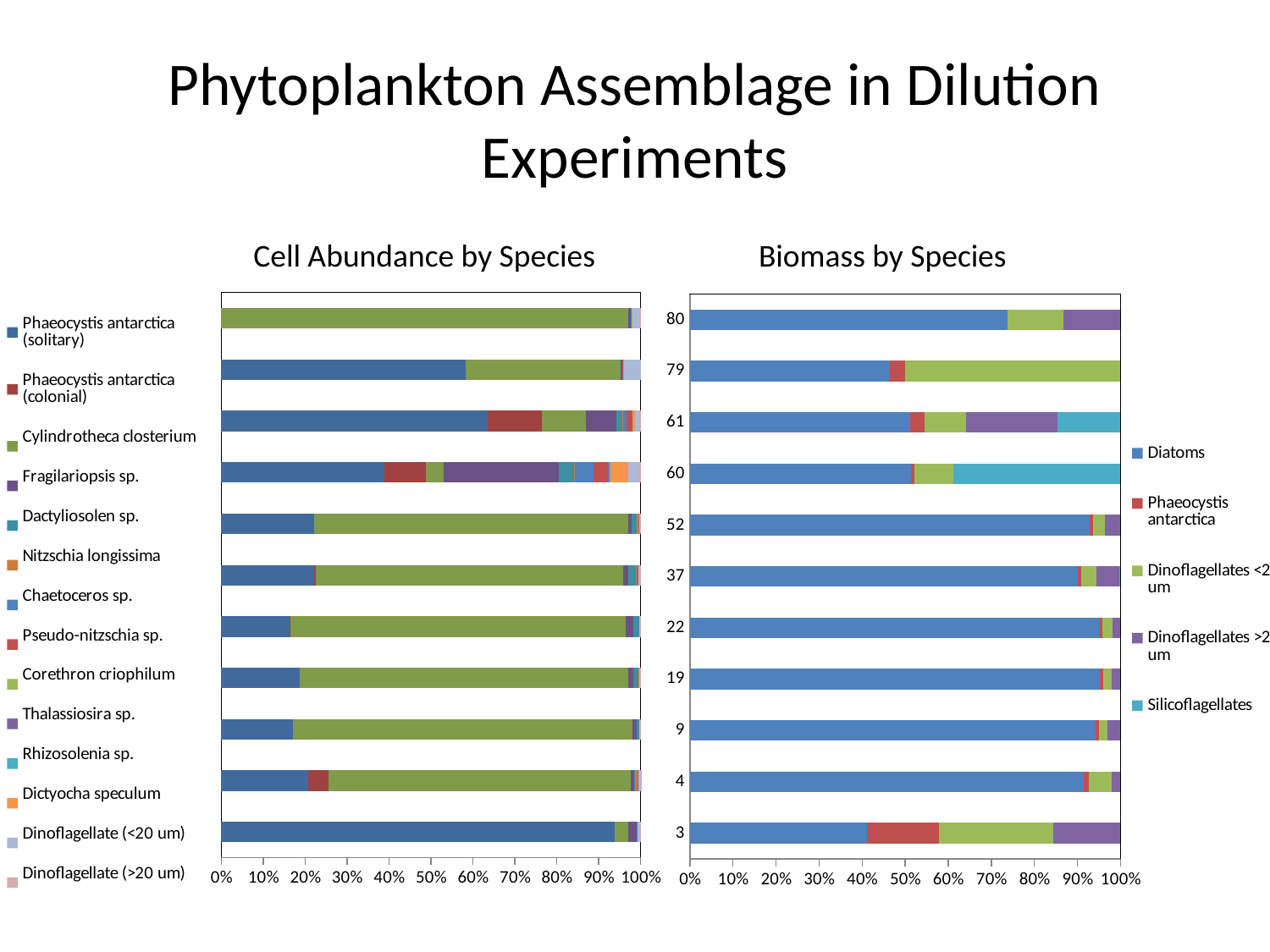
In the Biomass by Species chart, which category has the largest Dinoflagellates <2 um share? 79 What kind of chart is the Biomass by Species chart? Stacked bar chart How many series does the legend of the Cell Abundance by Species chart list? 14 In the Biomass by Species chart, which category has the largest Phaeocystis antarctica share? 3 How many bars are plotted in the Biomass by Species chart? 11 In the Biomass by Species chart, is the Diatoms share for category 79 greater or less than 60%? less In the Biomass by Species chart, is the Diatoms share for category 52 greater or less than 80%? greater What kind of chart is the Cell Abundance by Species chart? Stacked bar chart In the Biomass by Species chart, is the Diatoms share for category 3 greater or less than 50%? less How many series does the legend of the Biomass by Species chart list? 5 In the Biomass by Species chart, which category has the largest Silicoflagellates share? 60 In the Biomass by Species chart, which is larger for category 80: the Diatoms share or the Dinoflagellates >2 um share? Diatoms